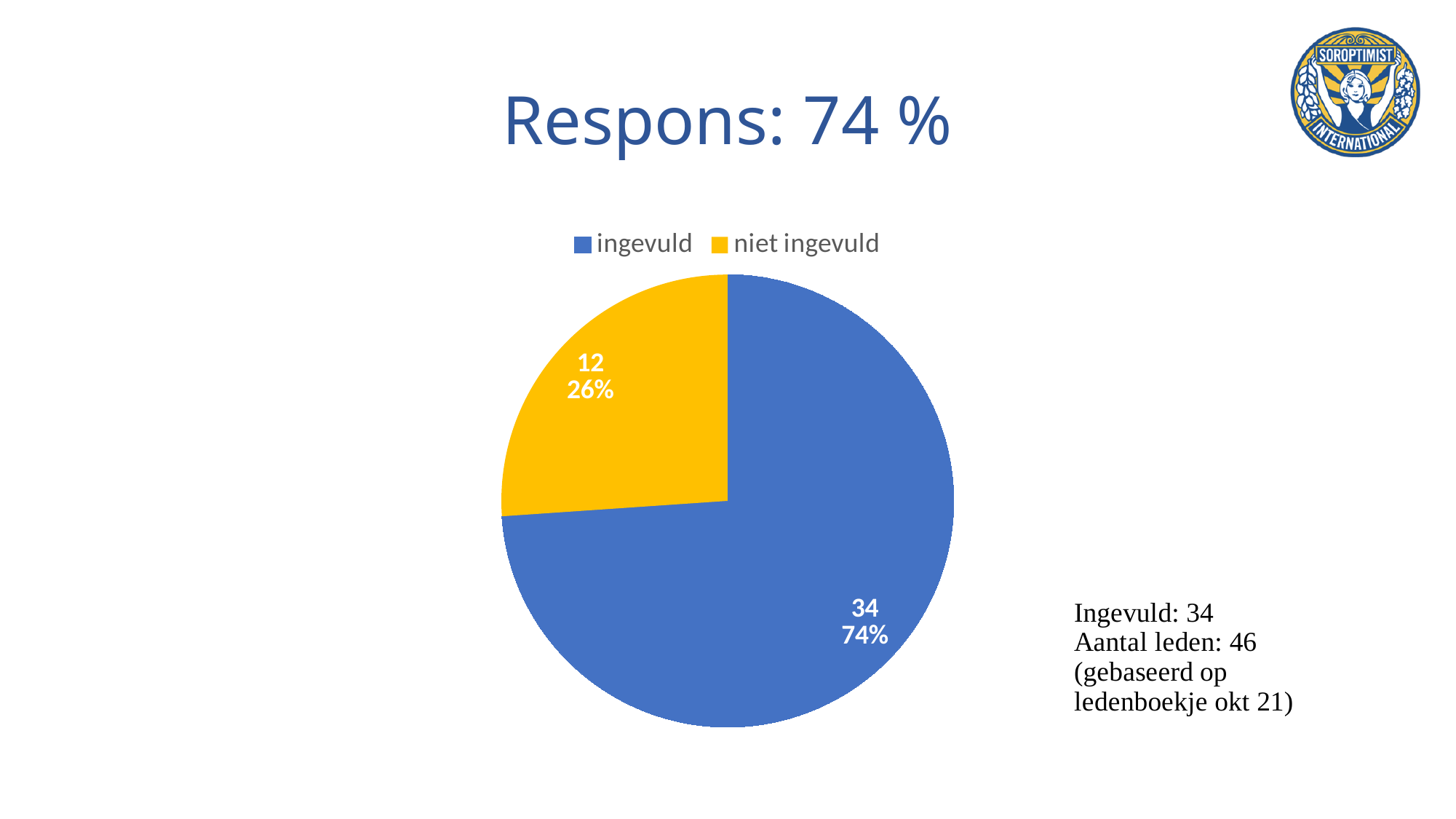
How many slices does the pie chart have? 2 Which slice is the smallest? niet ingevuld What is the value for 'niet ingevuld'? 12 Which is larger, 'ingevuld' or 'niet ingevuld'? ingevuld How many entries does the legend list? 2 What share of the pie does 'ingevuld' represent? 74% What is the value for 'ingevuld'? 34 What share of the pie does 'niet ingevuld' represent? 26% What is the difference between the values for 'ingevuld' and 'niet ingevuld'? 22 What kind of chart is shown on the slide? pie chart What colour is the 'niet ingevuld' slice? yellow Which slice is the largest? ingevuld